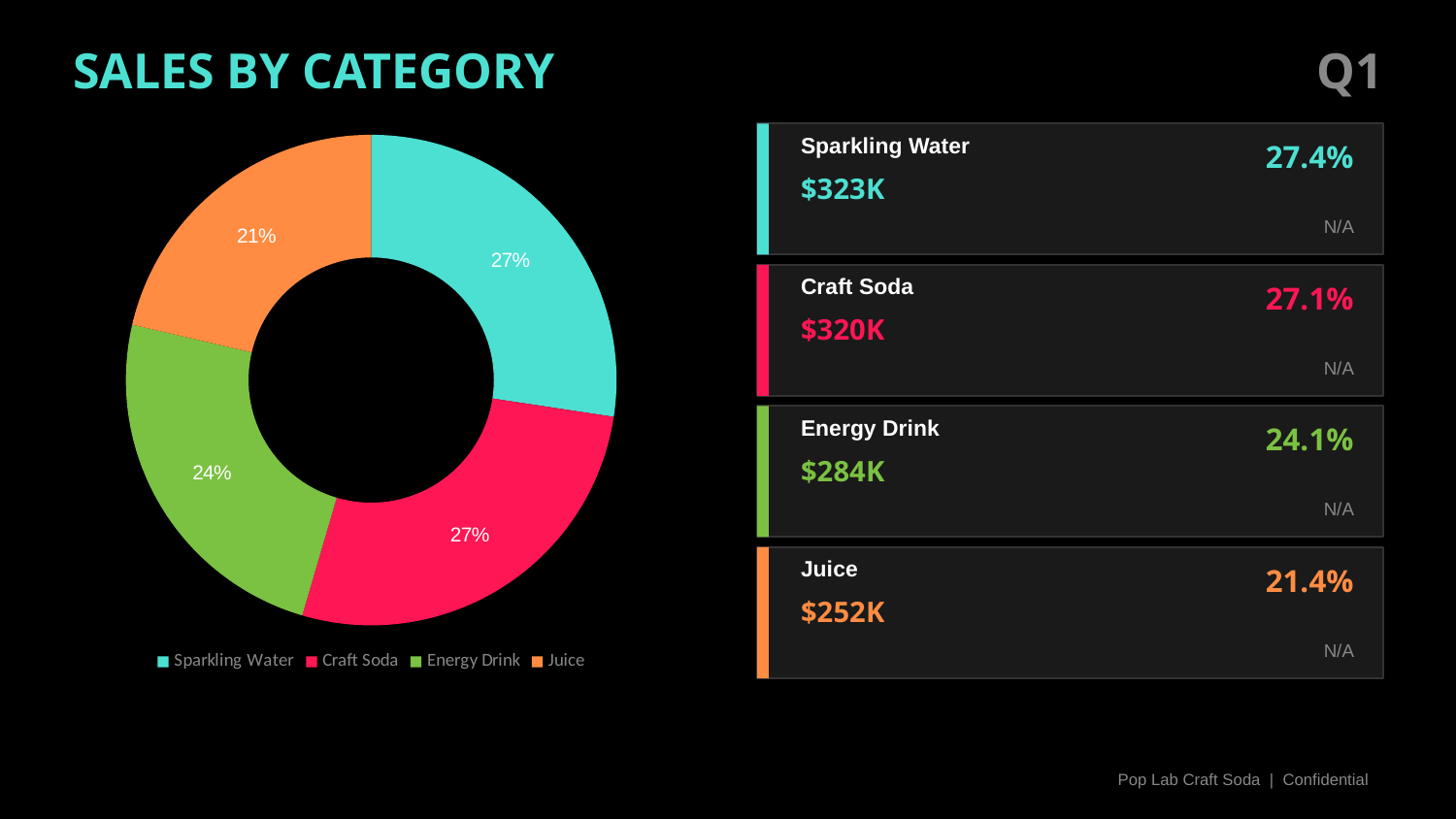
Which colour represents Craft Soda in the pie chart legend? Red (pink) What share of the pie chart does Juice represent? 21% What kind of chart is shown on the slide? Pie (donut) chart What is the value shown for Sparkling Water in the pie chart? 27% What is the title of the slide containing the pie chart? SALES BY CATEGORY Which category has the smallest slice in the pie chart? Juice Which slice is larger in the pie chart, Energy Drink or Juice? Energy Drink How many categories are shown in the pie chart? 4 What is the value shown for Craft Soda in the pie chart? 27% What is the value shown for Energy Drink in the pie chart? 24% What is the difference in percentage points between the Energy Drink slice and the Juice slice? 3 percentage points Which slice is larger in the pie chart, Sparkling Water or Energy Drink? Sparkling Water